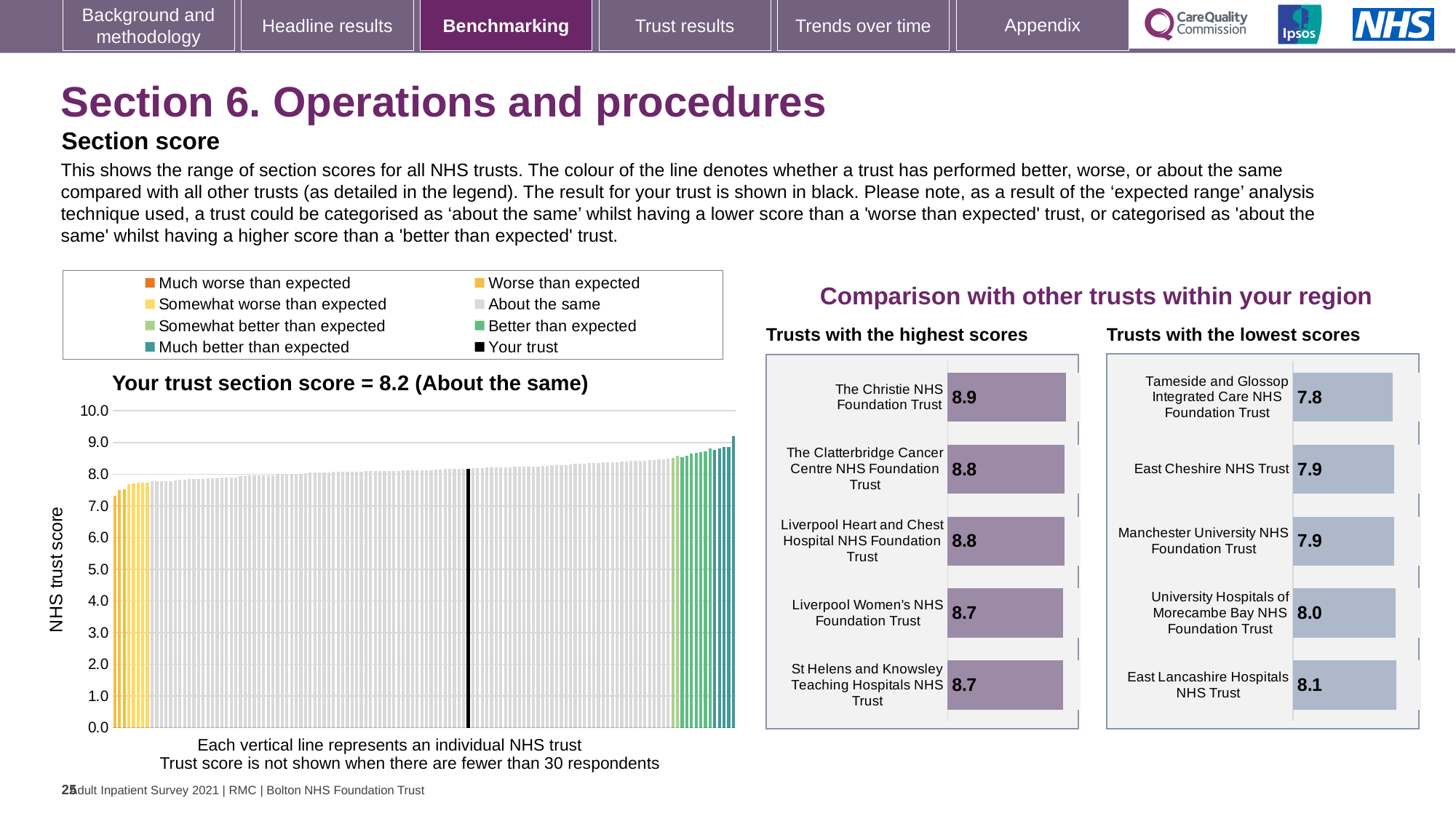
In the 'Your trust section score' chart, do the bar values rise or fall from left to right along the x axis? rise In the 'Trusts with the highest scores' chart, what is the score for The Christie NHS Foundation Trust? 8.9 In the 'Your trust section score' chart, is the value of the leftmost (lowest) bar greater or less than 8.0? less What is the y-axis label of the 'Your trust section score' chart? NHS trust score In the 'Trusts with the lowest scores' chart, which trust has the lowest score? Tameside and Glossop Integrated Care NHS Foundation Trust In the 'Your trust section score' chart, what is the section score for your trust? 8.2 How many entries does the legend above the 'Your trust section score' chart list? 8 In the 'Trusts with the lowest scores' chart, which has the higher score: East Lancashire Hospitals NHS Trust or University Hospitals of Morecambe Bay NHS Foundation Trust? East Lancashire Hospitals NHS Trust In the 'Trusts with the lowest scores' chart, what is the score for University Hospitals of Morecambe Bay NHS Foundation Trust? 8.0 In the 'Trusts with the highest scores' chart, what is the difference between the scores of The Christie NHS Foundation Trust and St Helens and Knowsley Teaching Hospitals NHS Trust? 0.2 In the 'Your trust section score' chart, what kind of chart is shown? bar chart In the 'Trusts with the highest scores' chart, how many trusts are shown? 5